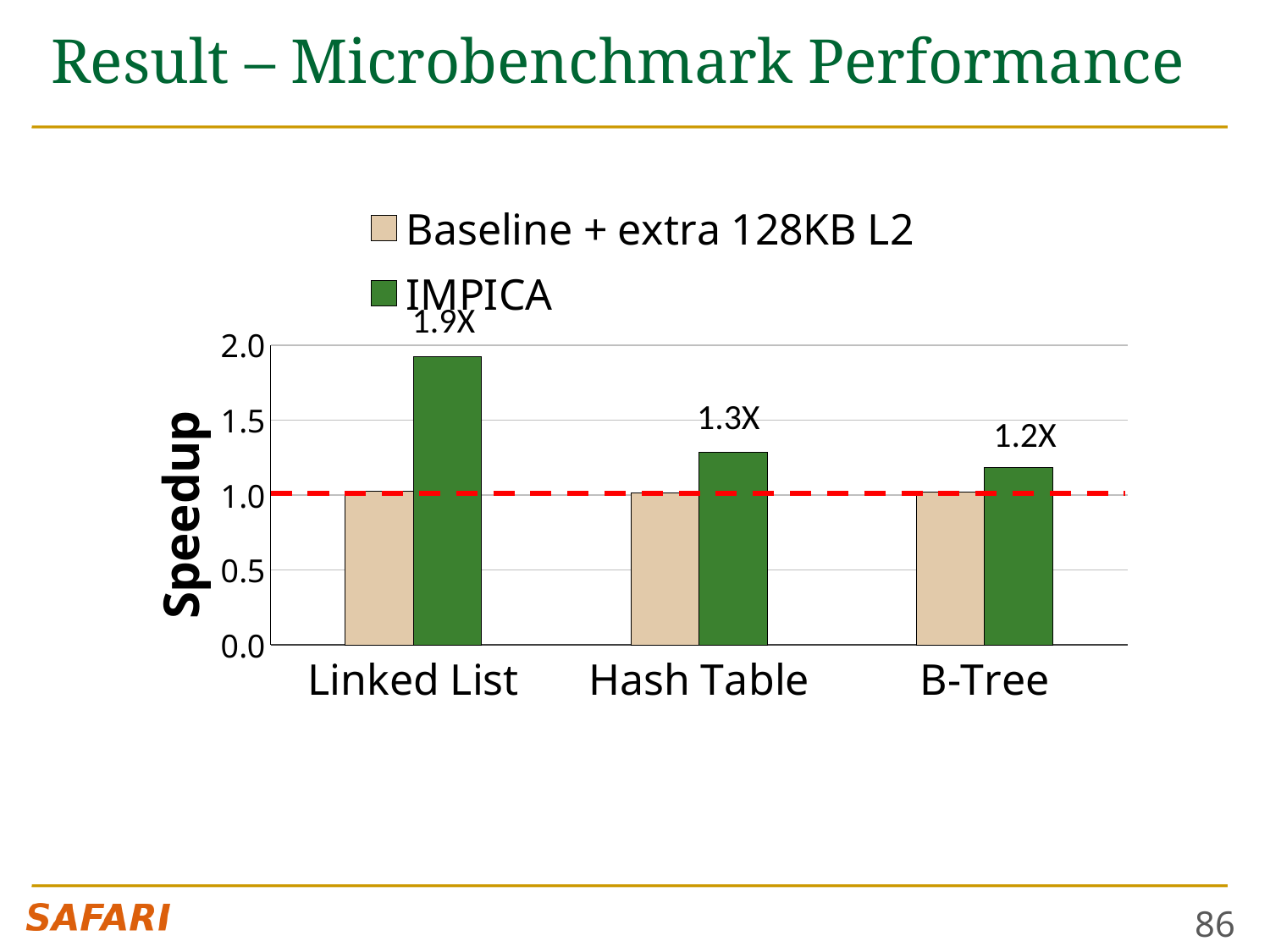
How many benchmarks are shown on the x axis? 3 Is the IMPICA speedup for Linked List greater or less than 1.5? greater What kind of chart is shown on the slide? bar chart Which benchmark has the highest IMPICA speedup? Linked List What is the difference between the IMPICA speedup for Linked List and for Hash Table? 0.6X What is the IMPICA speedup for Hash Table? 1.3X How many series does the legend list? 2 What is the IMPICA speedup for B-Tree? 1.2X Which benchmark has the lowest IMPICA speedup? B-Tree What is the IMPICA speedup for Linked List? 1.9X Is the IMPICA speedup for B-Tree greater or less than 1.5? less Which has a larger IMPICA speedup, Hash Table or B-Tree? Hash Table